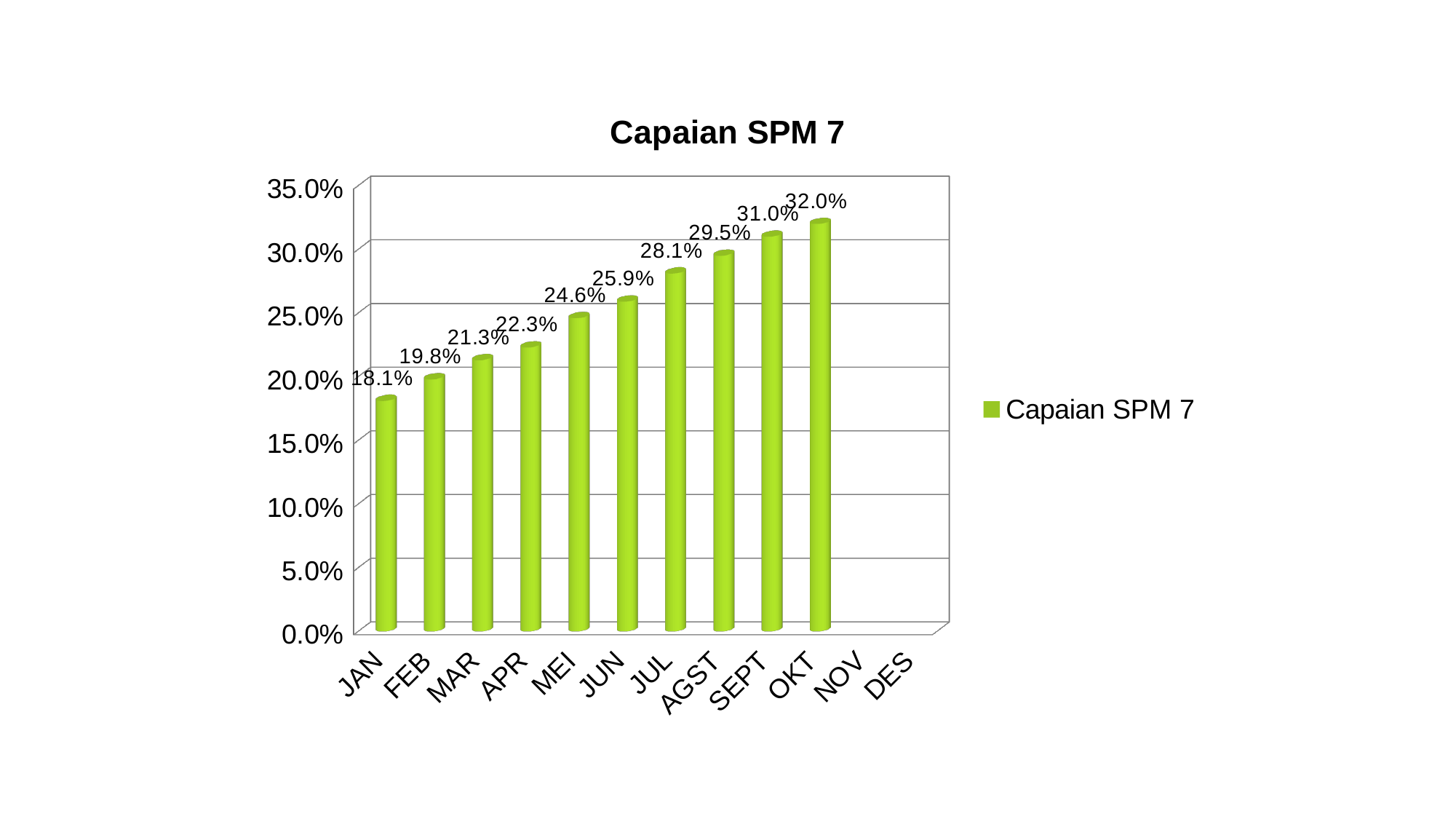
Do the values rise or fall from JAN to OKT? rise Is the value for SEPT greater or less than 30.0%? greater What is the difference between the values for JUL and JUN? 2.2% What kind of chart is this? bar chart How many months have a bar plotted? 10 What is the value for MAR? 21.3% What is the value for AGST? 29.5% What is the value for JAN? 18.1% Which month has the highest value? OKT What is the difference between the values for OKT and JAN? 13.9% Which month has the lowest plotted value? JAN Which is larger, the value for MEI or the value for APR? MEI